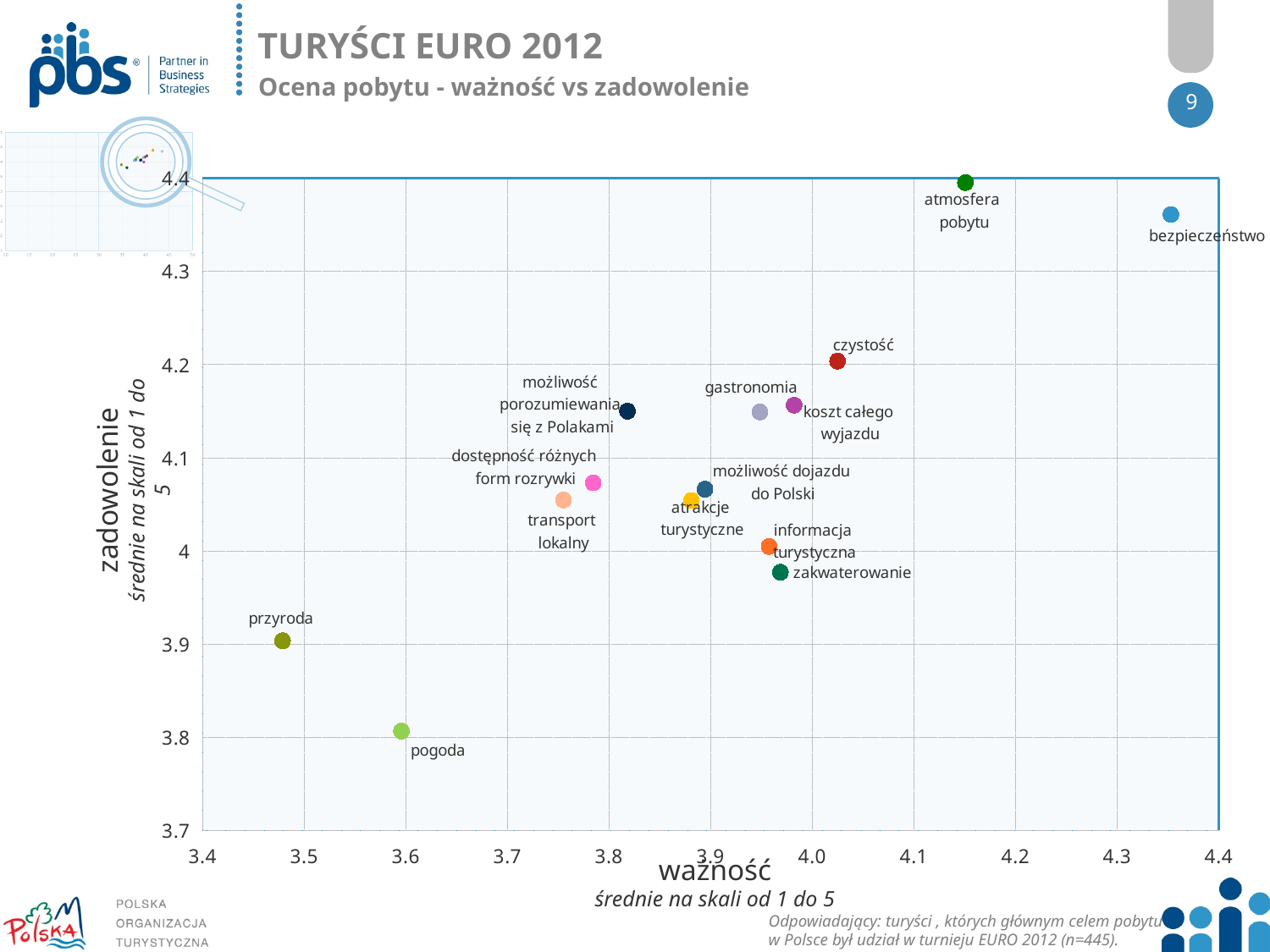
Which has the higher ważność value, atmosfera pobytu or przyroda? atmosfera pobytu Which category has the lowest ważność (importance) value? przyroda Which category has the highest ważność (importance) value? bezpieczeństwo What kind of chart is shown on the slide? scatter chart Which has the higher zadowolenie value, czystość or pogoda? czystość Which category has the lowest zadowolenie (satisfaction) value? pogoda Is the ważność value for pogoda greater or less than 3.7? less How many data points are plotted on the chart? 14 Is the ważność value for bezpieczeństwo greater or less than 4.3? greater Which category has the highest zadowolenie (satisfaction) value? atmosfera pobytu What is the title of the horizontal axis? ważność Is the zadowolenie value for przyroda greater or less than 4? less